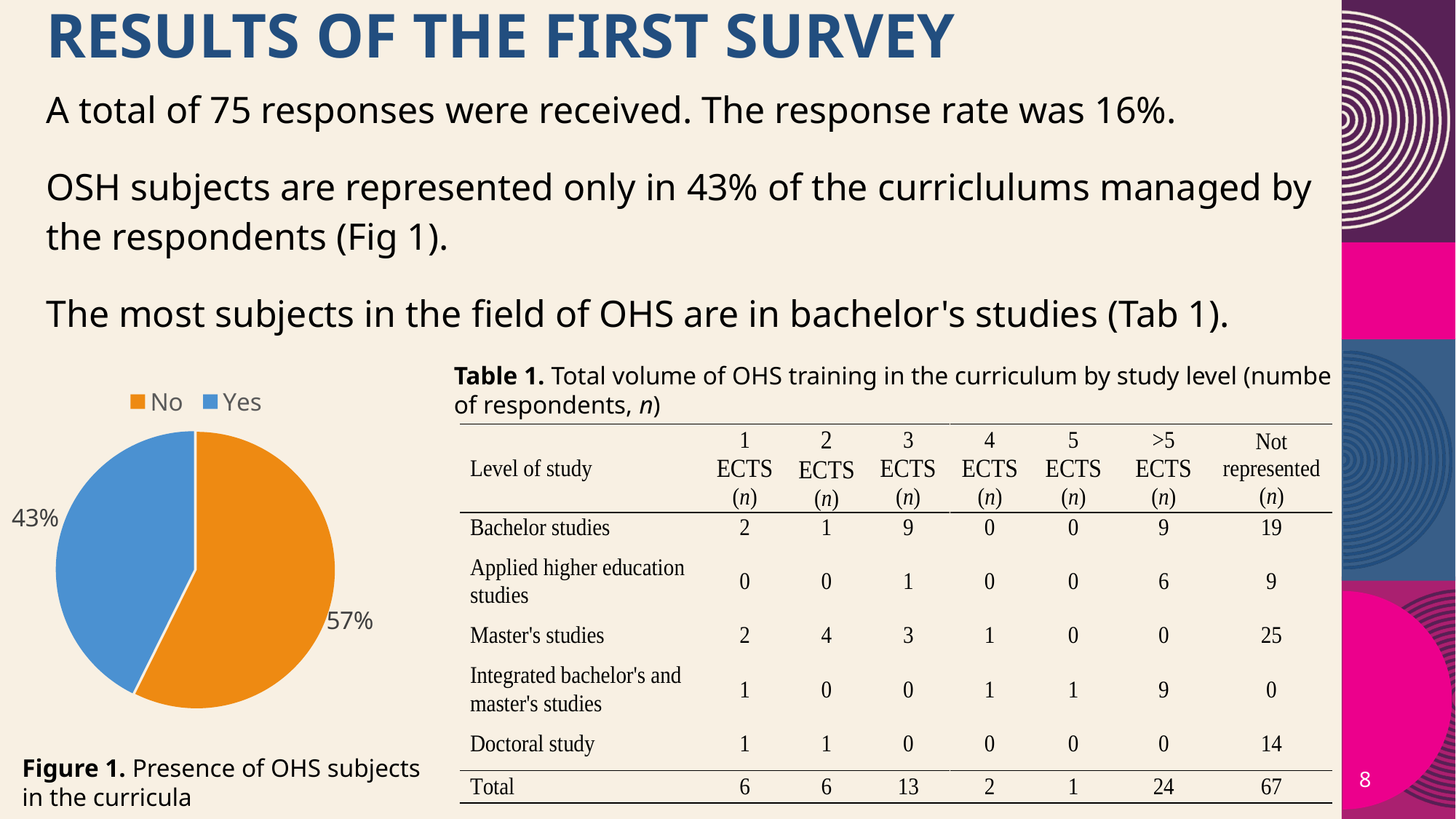
What colour is the 'Yes' slice in the pie chart? blue How many entries does the legend of the pie chart list? 2 What is the caption of the pie chart? Figure 1. Presence of OHS subjects in the curricula In the pie chart, what share is labelled for the 'No' slice? 57% What is the difference in percentage points between the 'No' and 'Yes' slices of the pie chart? 14 Is the 'No' slice of the pie chart greater or less than 50%? greater How many slices does the pie chart have? 2 What kind of chart is Figure 1? pie chart In the pie chart, which is larger: the 'No' slice or the 'Yes' slice? No Which slice of the pie chart is the largest? No Which slice of the pie chart is the smallest? Yes In the pie chart, what share is labelled for the 'Yes' slice? 43%